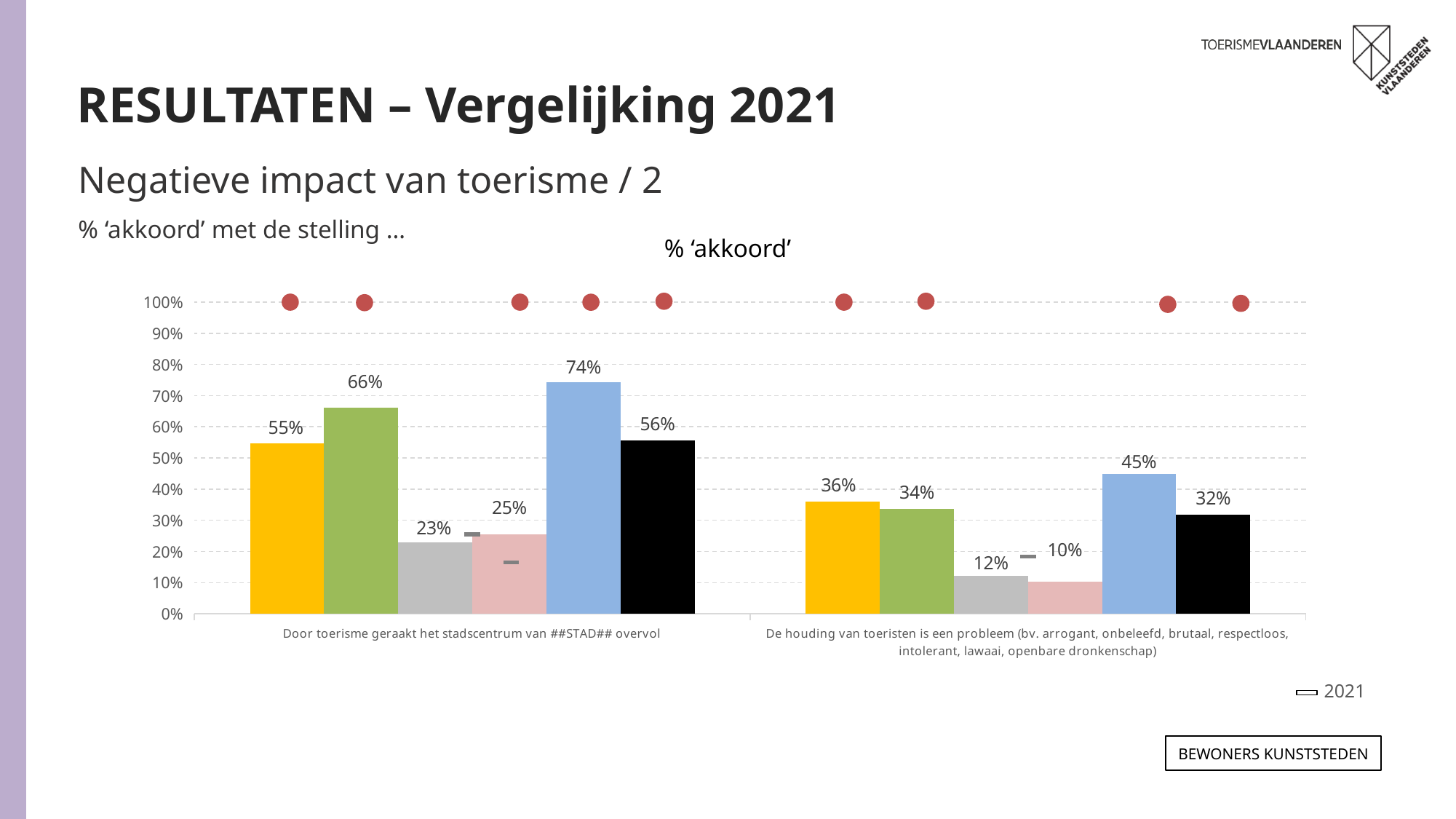
Which year does the legend entry refer to? 2021 What type of chart is shown on the slide? bar chart What is the value of the pink bar for the statement 'De houding van toeristen is een probleem'? 10% How many statement categories are shown on the x axis of the chart? 2 What is the difference between the green bar values for the two statements? 32% For the statement 'De houding van toeristen is een probleem', which is larger: the yellow bar or the green bar? the yellow bar (36%) What is the value of the yellow bar for the statement 'De houding van toeristen is een probleem'? 36% Which bar has the lowest value for the statement 'De houding van toeristen is een probleem'? the pink bar (10%) What is the difference between the blue bar and the black bar for the statement 'Door toerisme geraakt het stadscentrum van ##STAD## overvol'? 18% What is the value of the blue bar for the statement 'Door toerisme geraakt het stadscentrum van ##STAD## overvol'? 74% Which bar has the highest value for the statement 'Door toerisme geraakt het stadscentrum van ##STAD## overvol'? the blue bar (74%) What is the title of the chart? % ‘akkoord’